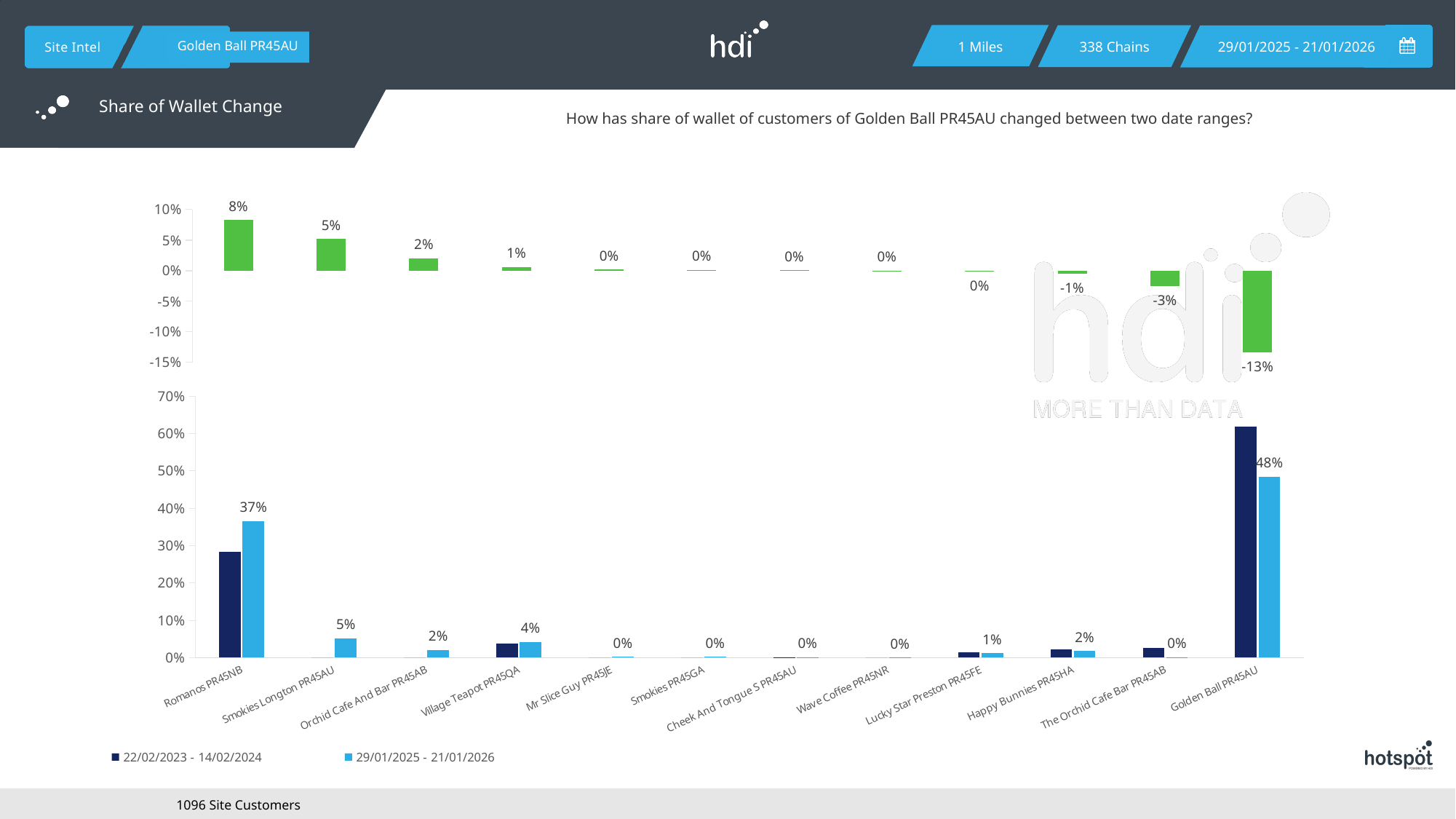
In the top chart, which category has the highest share of wallet change? Romanos PR45NB In the bottom chart, what is the share of wallet for Golden Ball PR45AU in the 29/01/2025 - 21/01/2026 period? 48% How many categories are shown on the x axis of the bottom chart? 12 How many series does the legend of the bottom chart list? 2 In the bottom chart, is the 22/02/2023 - 14/02/2024 value for Golden Ball PR45AU greater or less than 50%? greater In the top chart, what is the share of wallet change for Golden Ball PR45AU? -13% In the top chart, what is the difference between the change for Smokies Longton PR45AU and The Orchid Cafe Bar PR45AB? 8% In the bottom chart, what is the share of wallet for Romanos PR45NB in the 29/01/2025 - 21/01/2026 period? 37% In the bottom chart, which is larger for Village Teapot PR45QA in the 29/01/2025 - 21/01/2026 period: its value or the value for Happy Bunnies PR45HA in the same period? Village Teapot PR45QA In the top chart, which category has the lowest share of wallet change? Golden Ball PR45AU What type of chart is the bottom chart? bar chart In the top chart, what is the share of wallet change for Romanos PR45NB? 8%